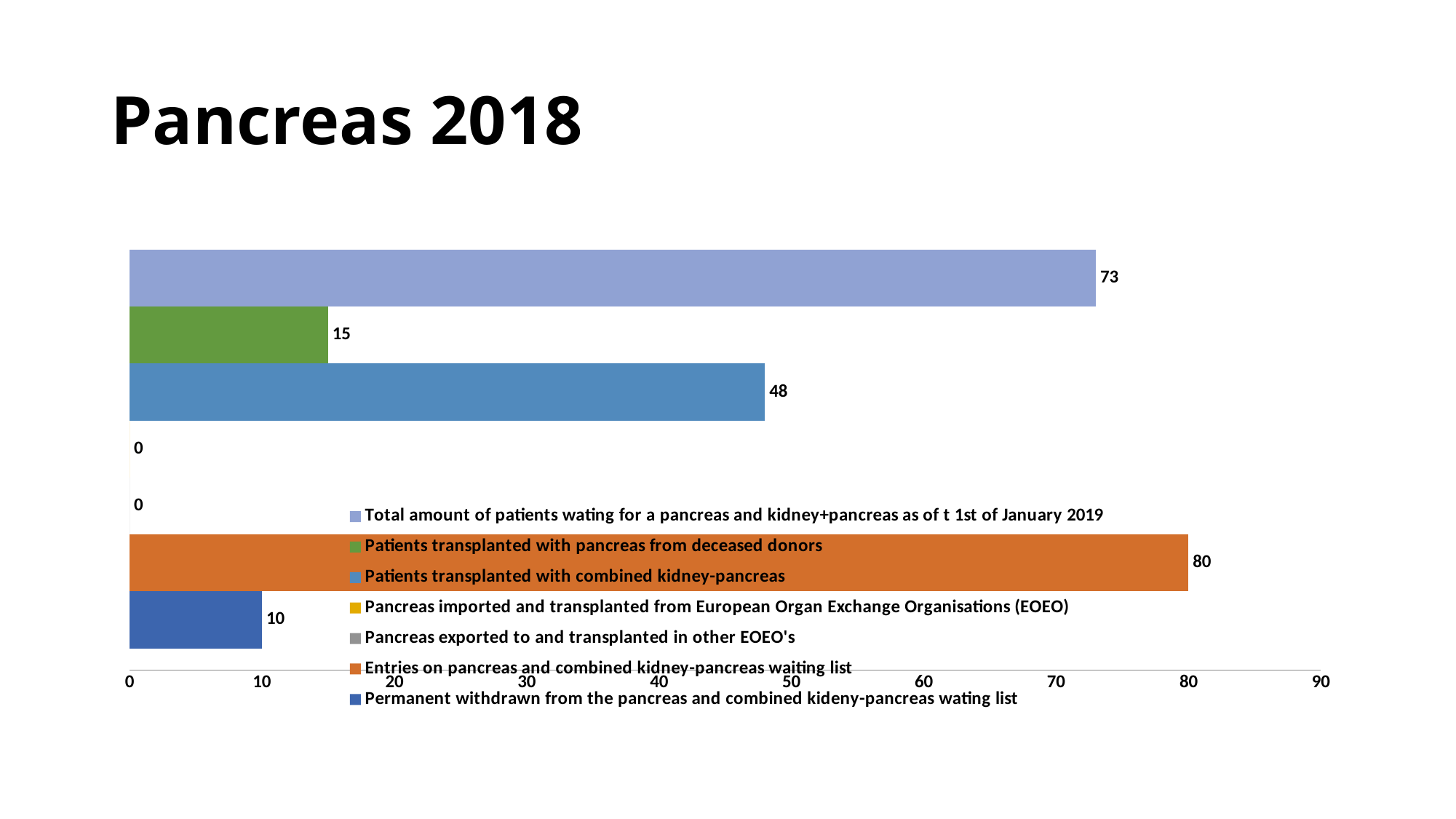
What is the highest value shown on the x axis? 90 What is the value for 'Patients transplanted with pancreas from deceased donors'? 15 Which series has the highest value? Entries on pancreas and combined kidney-pancreas waiting list What is the value for 'Pancreas imported and transplanted from European Organ Exchange Organisations (EOEO)'? 0 What is the title of the slide? Pancreas 2018 How many series does the legend list? 7 What is the value for 'Entries on pancreas and combined kidney-pancreas waiting list'? 80 What is the difference between the total amount of patients waiting as of 1st of January 2019 and the patients transplanted with combined kidney-pancreas? 25 Which is larger: patients transplanted with combined kidney-pancreas or patients transplanted with pancreas from deceased donors? Patients transplanted with combined kidney-pancreas What kind of chart is shown on the slide? Bar chart What is the value for 'Permanent withdrawn from the pancreas and combined kideny-pancreas wating list'? 10 What is the value for 'Patients transplanted with combined kidney-pancreas'? 48